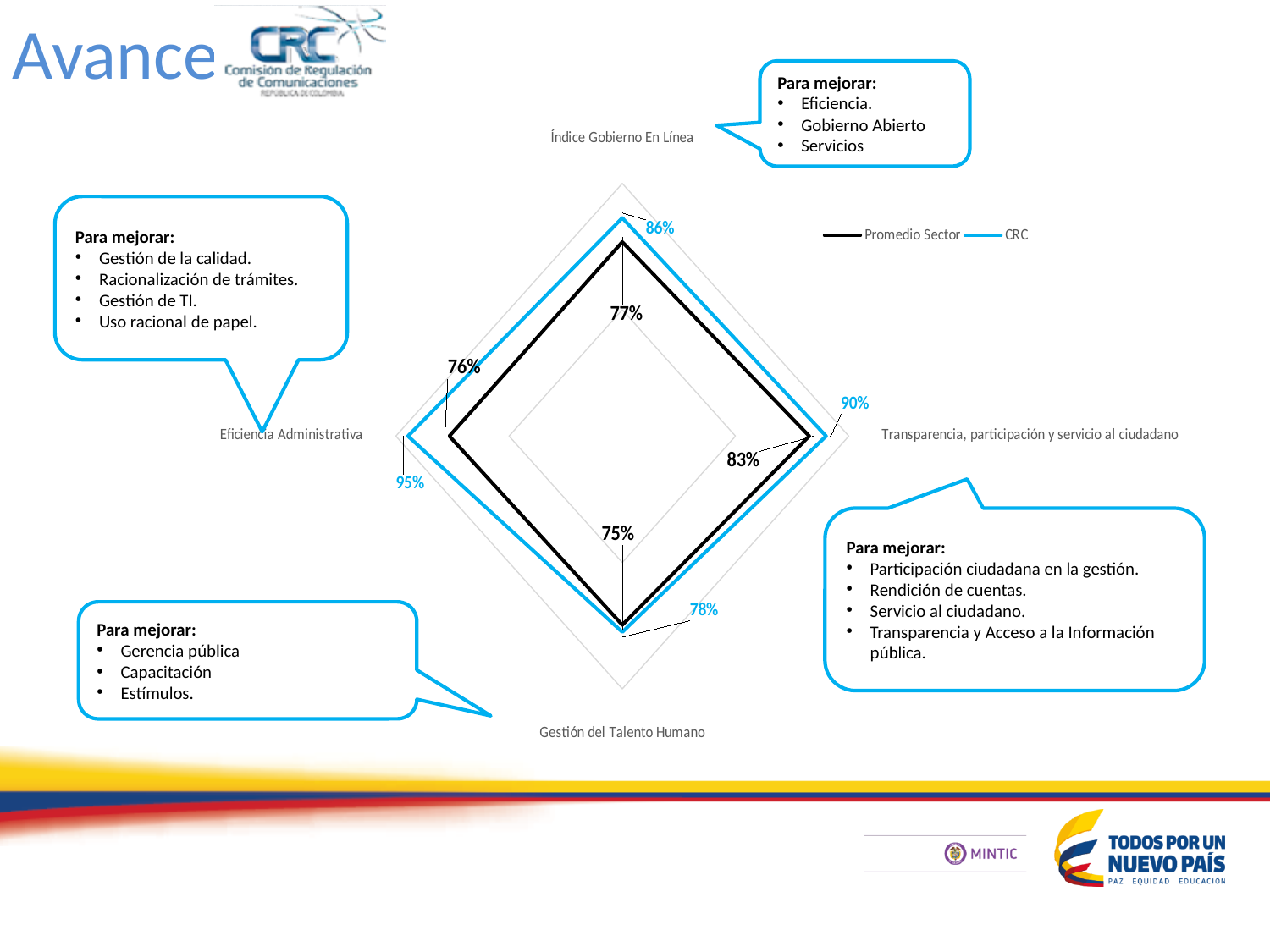
What is the CRC value for Índice Gobierno En Línea? 86% Which series has the larger value for Eficiencia Administrativa, CRC or Promedio Sector? CRC How many categories (axes) does the radar chart have? 4 How many series does the chart legend list? 2 What is the Promedio Sector value for Gestión del Talento Humano? 75% In which category does CRC have its highest value? Eficiencia Administrativa What is the CRC value for Eficiencia Administrativa? 95% What is the difference between the CRC value and the Promedio Sector value for Transparencia, participación y servicio al ciudadano? 7% What are the two series named in the chart legend? Promedio Sector and CRC What kind of chart is shown on the slide? Radar chart What is the Promedio Sector value for Índice Gobierno En Línea? 77% In which category does CRC have its lowest value? Gestión del Talento Humano